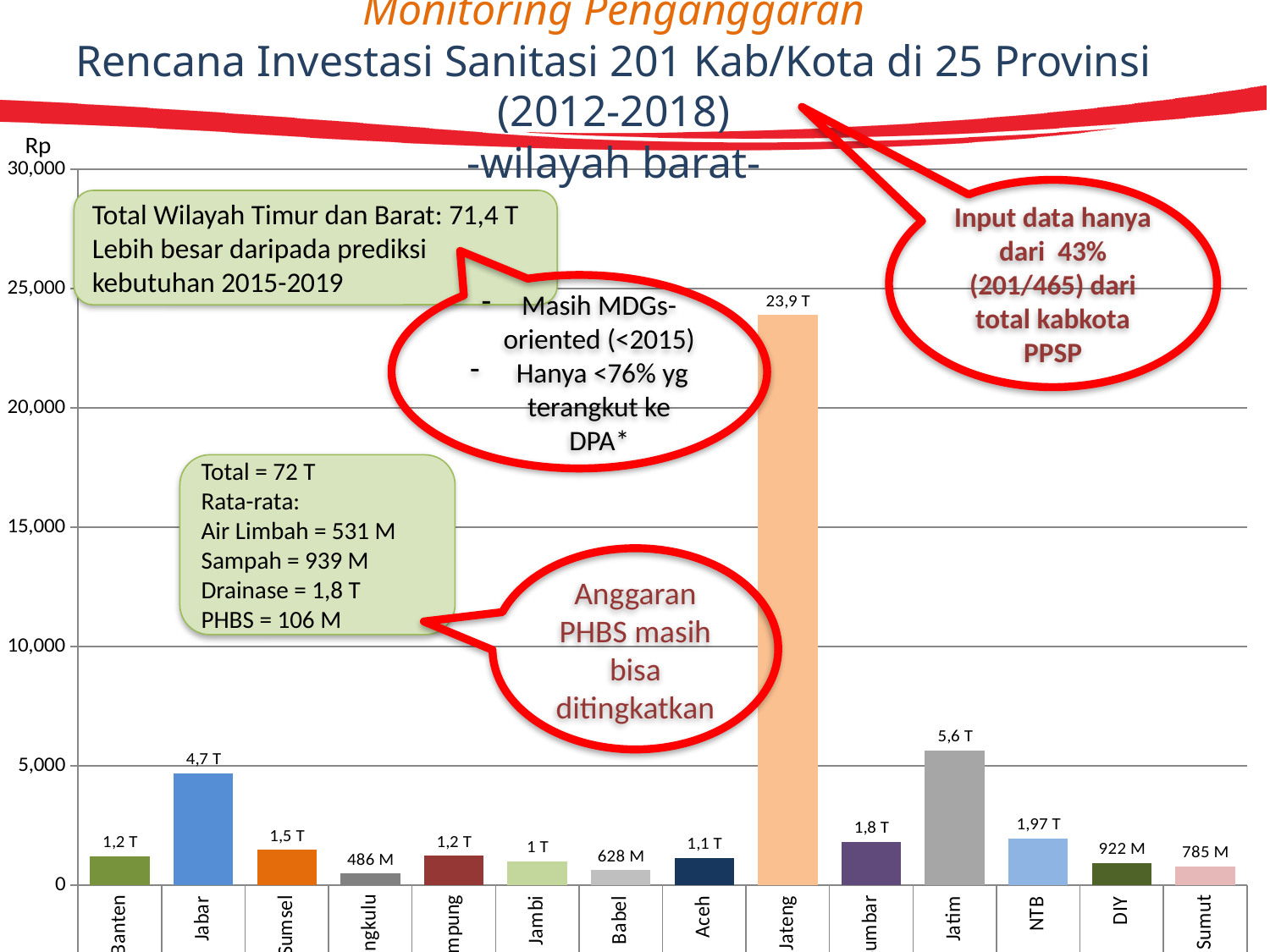
Is the value for Jateng greater or less than 20,000? greater What is the difference between the values for Jatim and Jabar? 954 M How many provinces are shown on the x axis? 14 What is the value for Jatim? 5,6 T What kind of chart is shown on the slide? Bar chart What unit label is shown at the top of the y axis? Rp Which province has the highest bar? Jateng What is the value for NTB? 1,97 T What is the value for Jateng? 23,9 T Which is larger, the value for Jabar or the value for Jatim? Jatim What is the value for Jabar? 4,7 T Which is larger, the value for DIY or the value for Sumut? DIY